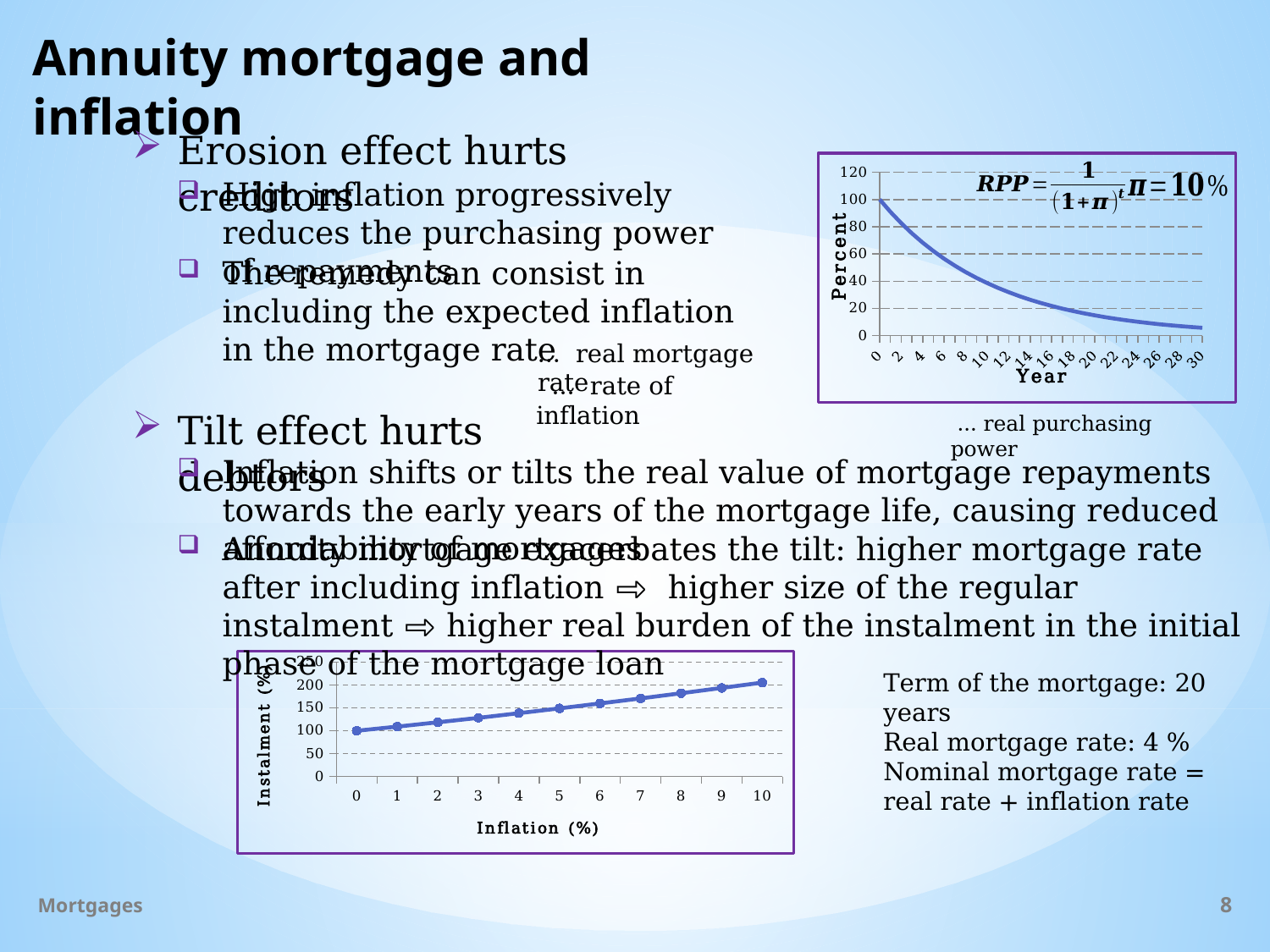
What is the x-axis title of the bottom chart on the slide? Inflation (%) What kind of chart is the chart at the bottom of the slide (Instalment (%) vs Inflation (%))? line chart What kind of chart is the chart in the top right of the slide (Percent vs Year)? line chart In the bottom chart (Instalment (%) vs Inflation (%)), is the value at Inflation 5 greater or less than 100? greater In the bottom chart (Instalment (%) vs Inflation (%)), what is the Instalment value at Inflation 0? 100 In the top-right chart (Percent vs Year), is the value at Year 10 greater or less than 60? less In the top-right chart (Percent vs Year), what is the value at Year 0? 100 In the top-right chart (Percent vs Year), do the values rise or fall as Year increases? fall In the top-right chart (Percent vs Year), at which Year is the value highest? 0 In the top-right chart (Percent vs Year), is the value at Year 30 greater or less than 20? less In the bottom chart (Instalment (%) vs Inflation (%)), how many data points are plotted? 11 In the bottom chart (Instalment (%) vs Inflation (%)), do the values rise or fall as Inflation increases? rise